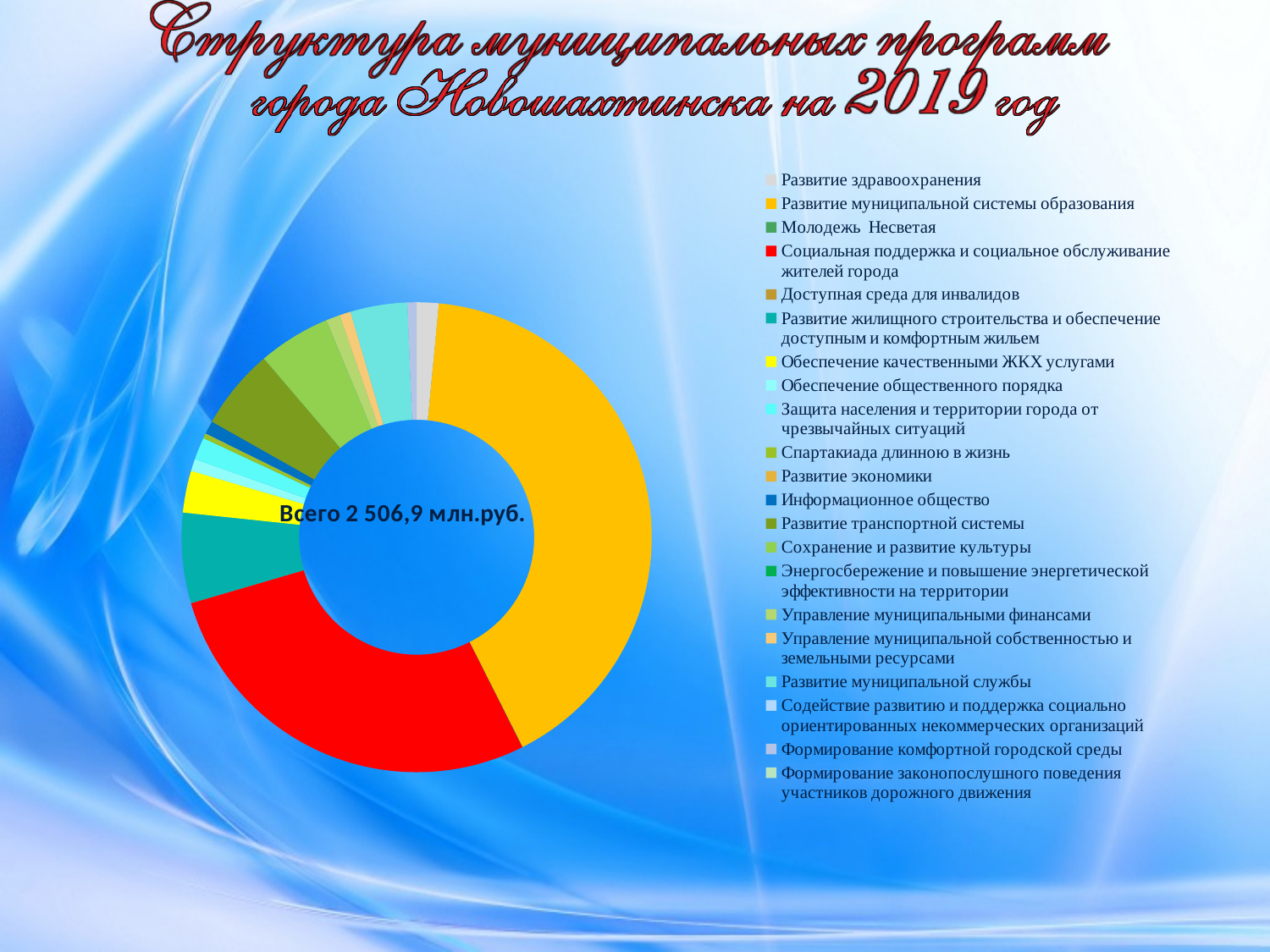
Which is larger: the slice for Социальная поддержка и социальное обслуживание жителей города or the slice for Развитие жилищного строительства и обеспечение доступным и комфортным жильем? Социальная поддержка и социальное обслуживание жителей города What colour is the largest slice of the doughnut chart? Yellow-orange Which programme is represented by the red slice of the chart? Социальная поддержка и социальное обслуживание жителей города Which is larger: the slice for Обеспечение качественными ЖКХ услугами or the slice for Социальная поддержка и социальное обслуживание жителей города? Социальная поддержка и социальное обслуживание жителей города What total amount is printed in the centre of the doughnut chart? 2 506,9 млн.руб. What is the title of the chart on the slide? Структура муниципальных программ города Новошахтинска на 2019 год How many categories does the chart legend list? 21 Which is larger: the slice for Развитие муниципальной системы образования or the slice for Социальная поддержка и социальное обслуживание жителей города? Развитие муниципальной системы образования Which municipal programme has the largest share of the chart? Развитие муниципальной системы образования What kind of chart is shown on the slide? Doughnut (pie) chart